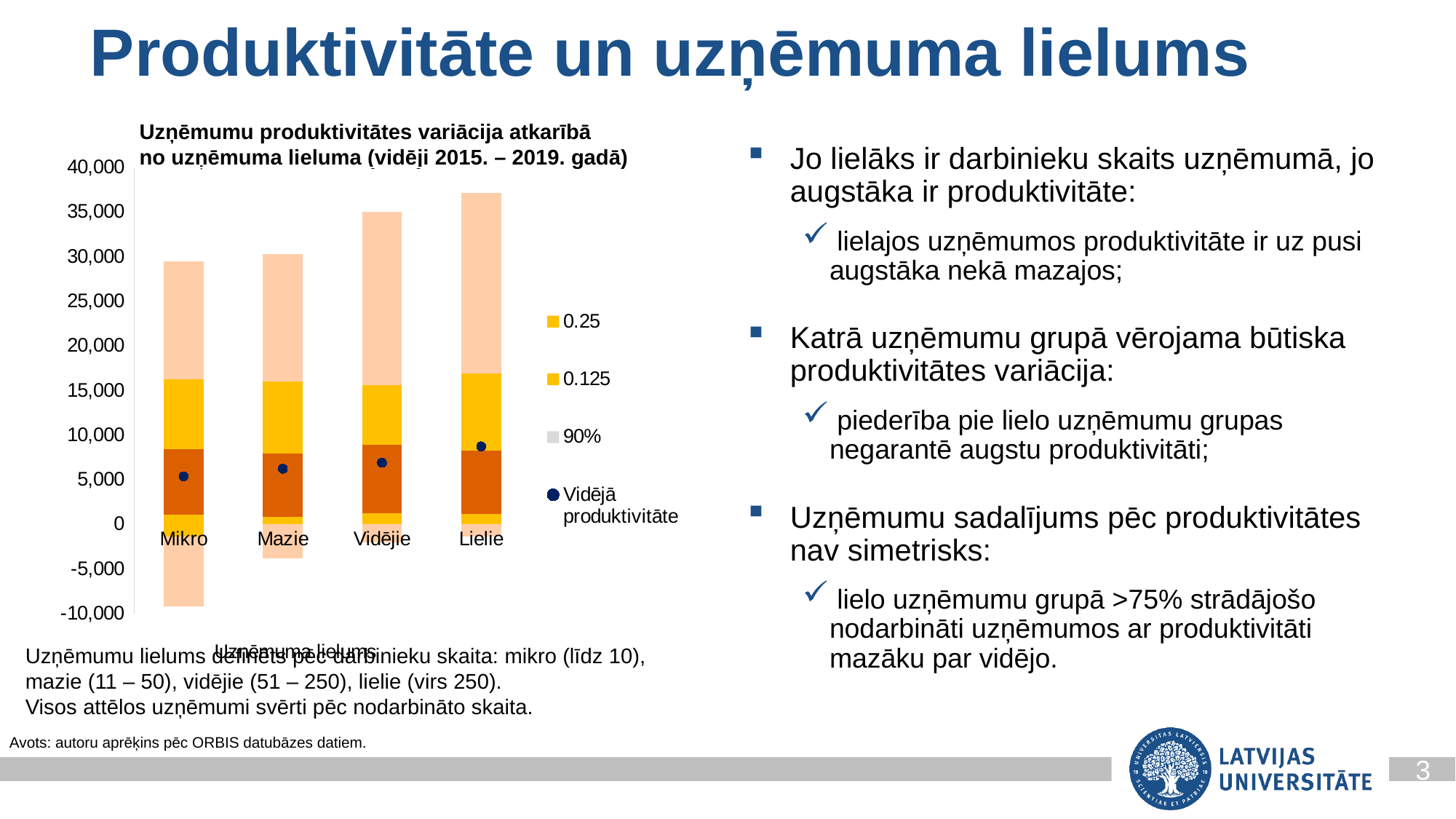
What is the title of the chart? Uzņēmumu produktivitātes variācija atkarībā no uzņēmuma lieluma (vidēji 2015. – 2019. gadā) Is the average productivity marker for Lielie greater or less than 10,000? less Is the top of the bar for Lielie greater or less than 35,000? greater Which category's bar reaches the highest value on the chart? Lielie Which category's bar extends to the lowest (most negative) value on the chart? Mikro How many entries does the chart legend list? 4 How many company size categories are shown on the x axis of the chart? 4 Is the average productivity marker for Vidējie greater or less than 5,000? greater Which company size category has the highest average productivity (Vidējā produktivitāte) marker? Lielie Which company size category has the lowest average productivity (Vidējā produktivitāte) marker? Mikro What kind of chart is shown on the slide? Stacked bar chart Does the average productivity marker rise or fall moving from Mikro to Lielie along the x axis? Rises